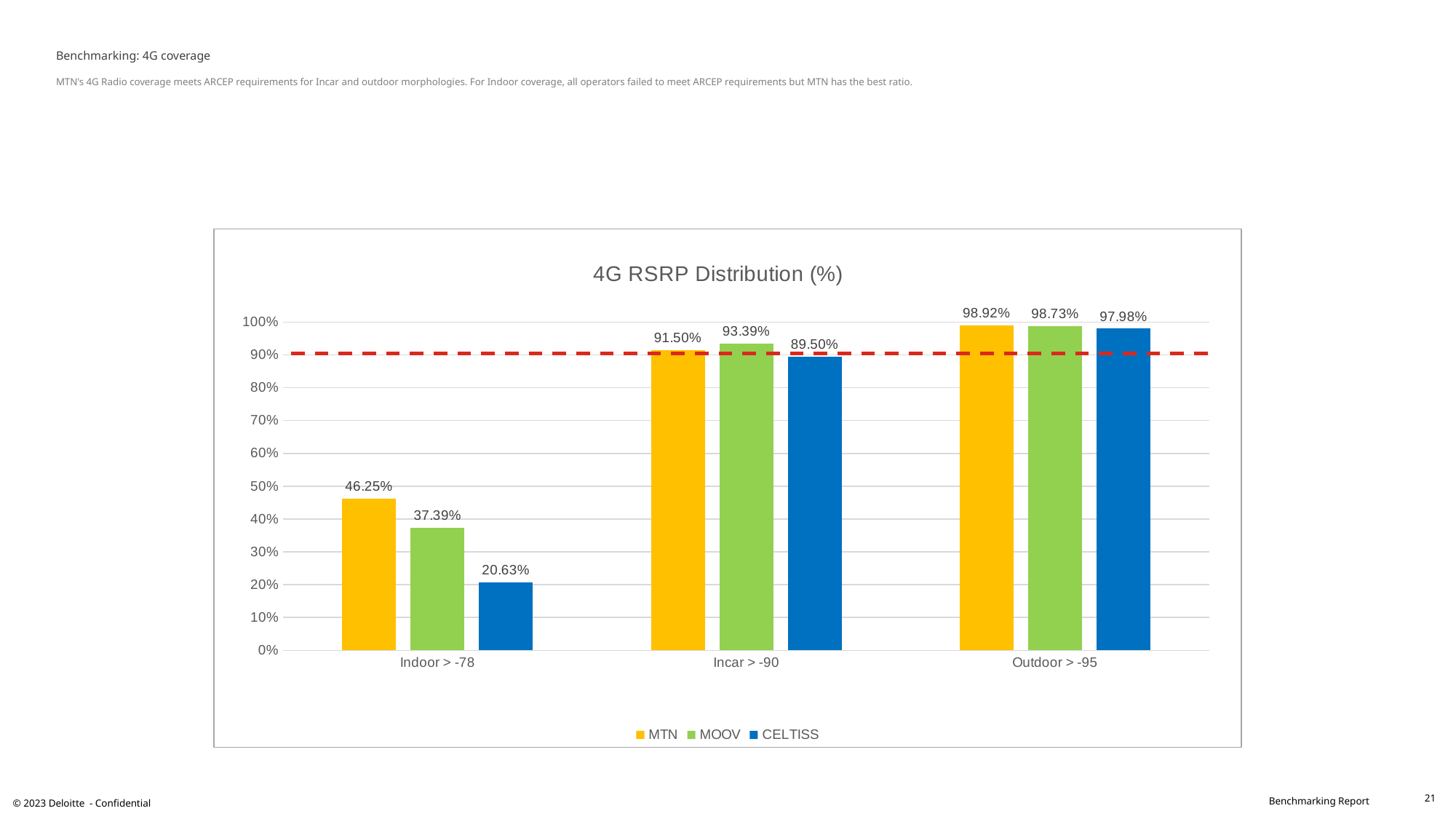
Which operator has the lowest value in the Indoor > -78 category? CELTISS What is the value for CELTISS in the Incar > -90 category? 89.50% What is the value for MOOV in the Outdoor > -95 category? 98.73% What is the title of the chart? 4G RSRP Distribution (%) What is the difference between MTN and MOOV in the Indoor > -78 category? 8.86% How many series does the legend list? 3 How many categories are shown on the x axis? 3 What is the value for MTN in the Indoor > -78 category? 46.25% Which is larger: MTN's value for Incar > -90 or MOOV's value for Incar > -90? MOOV's value for Incar > -90 Is the value for CELTISS in the Indoor > -78 category greater or less than 30%? less What kind of chart is shown on the slide? Bar chart Which operator has the highest value in the Incar > -90 category? MOOV